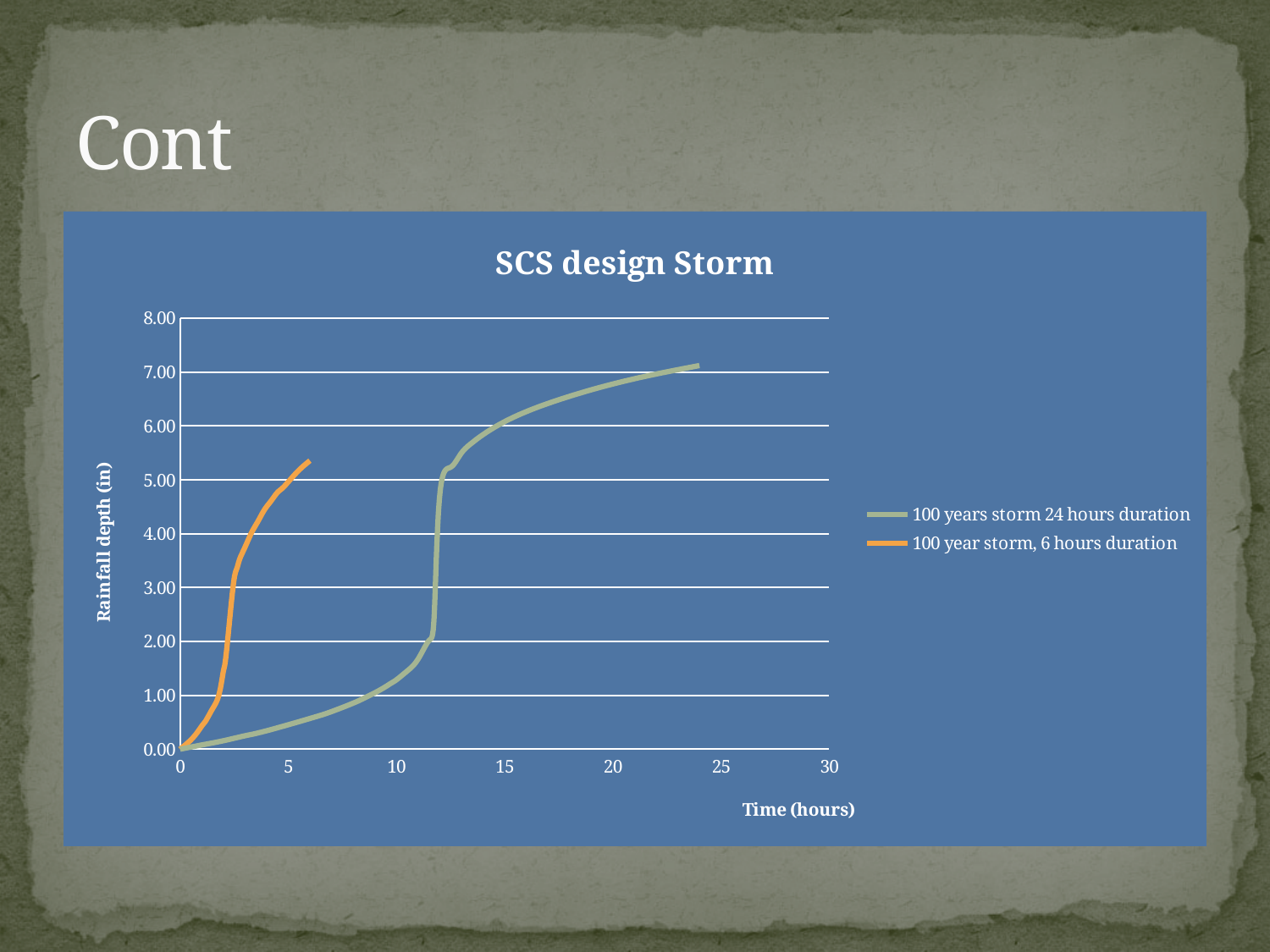
At 5 hours, which series has the higher rainfall depth? 100 year storm, 6 hours duration Which series reaches the higher rainfall depth at the end of its duration? 100 years storm 24 hours duration Is the value of the '100 years storm 24 hours duration' series at 5 hours greater or less than 1.00? less How many series does the legend list? 2 What is the label of the vertical axis? Rainfall depth (in) What is the title of the chart? SCS design Storm Is the value of the '100 years storm 24 hours duration' series at 20 hours greater or less than 6.00? greater Is the value of the '100 years storm 24 hours duration' series at 10 hours greater or less than 2.00? less Do the values of the '100 years storm 24 hours duration' series rise or fall as time increases? rise What kind of chart is shown on the slide? line chart